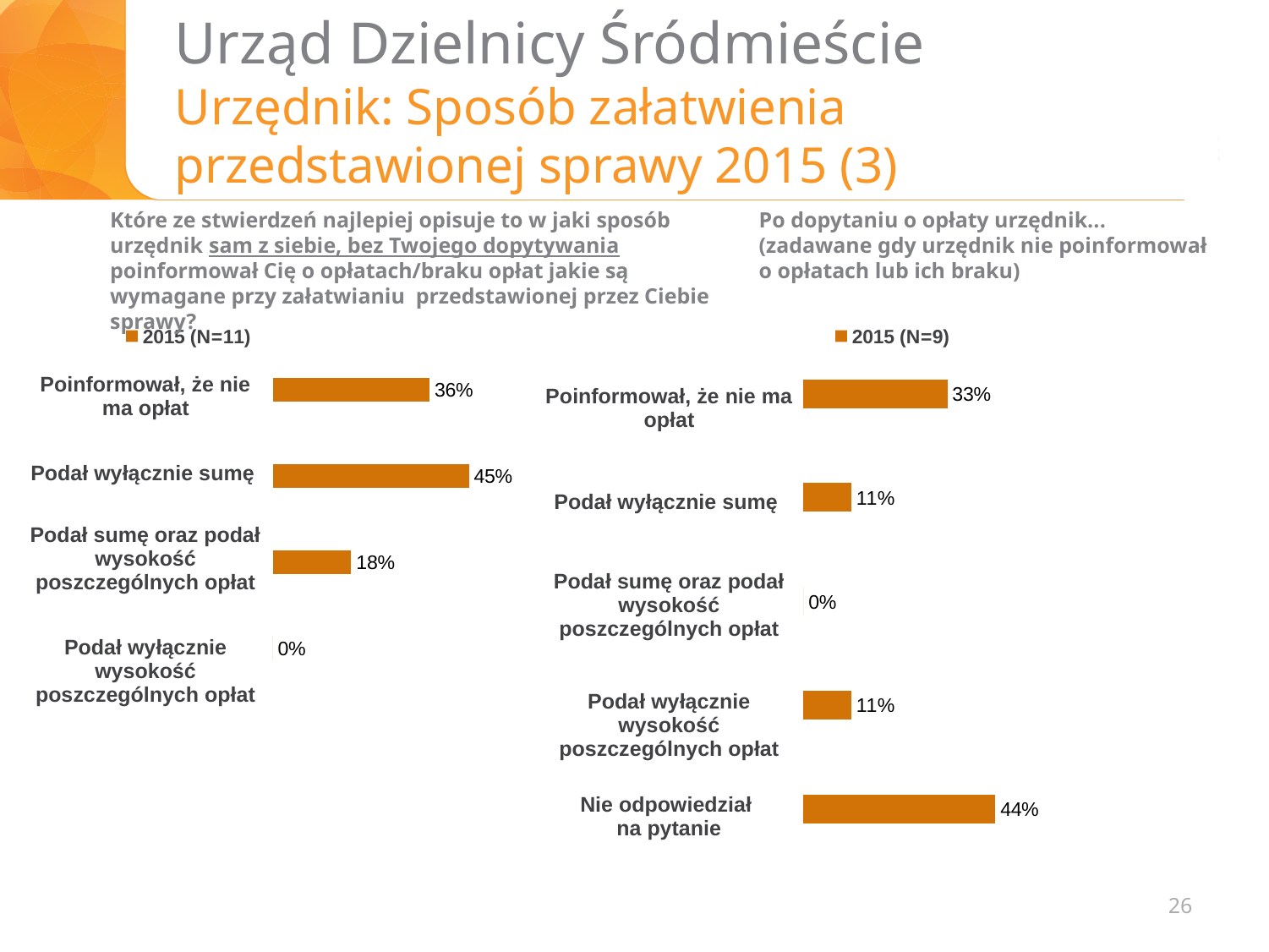
In the left chart (2015, N=11), what is the value for 'Podał wyłącznie sumę'? 45% In the right chart (2015, N=9), which is larger: 'Poinformował, że nie ma opłat' or 'Podał wyłącznie wysokość poszczególnych opłat'? Poinformował, że nie ma opłat How many categories does the left chart (2015, N=11) show? 4 In the right chart (2015, N=9), what is the value for 'Podał wyłącznie sumę'? 11% How many categories does the right chart (2015, N=9) show? 5 In the left chart (2015, N=11), which category has the lowest value? Podał wyłącznie wysokość poszczególnych opłat In the left chart (2015, N=11), which category has the highest value? Podał wyłącznie sumę In the left chart (2015, N=11), what is the value for 'Poinformował, że nie ma opłat'? 36% In the right chart (2015, N=9), which category has the highest value? Nie odpowiedział na pytanie What type of chart is the left chart (2015, N=11)? Bar chart In the right chart (2015, N=9), what is the value for 'Nie odpowiedział na pytanie'? 44% In the left chart (2015, N=11), what is the difference between 'Podał wyłącznie sumę' and 'Podał sumę oraz podał wysokość poszczególnych opłat'? 27%